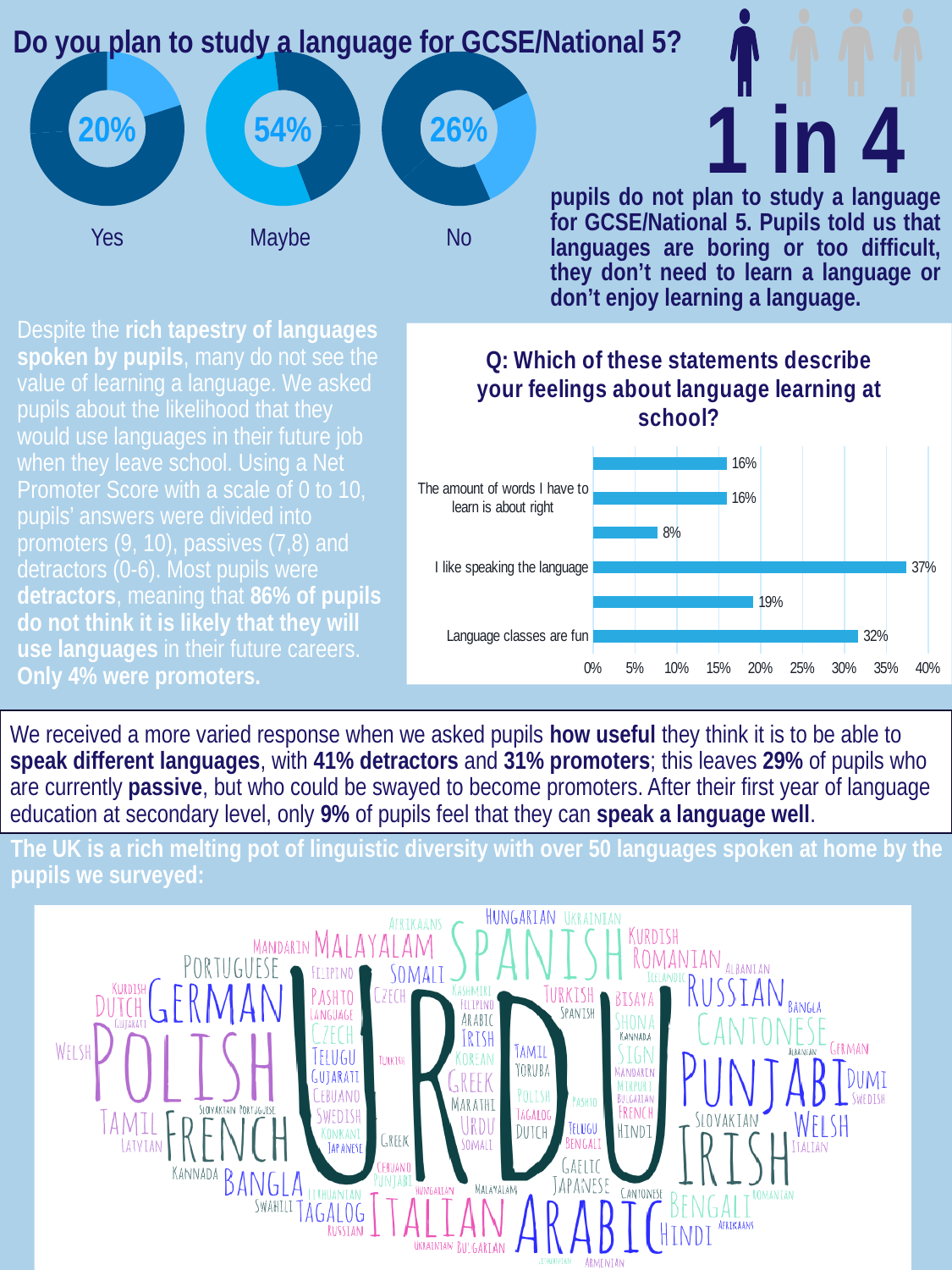
In the bar chart 'Which of these statements describe your feelings about language learning at school?', how many bars are plotted? 6 In the donut charts for 'Do you plan to study a language for GCSE/National 5?', what percentage of pupils answered No? 26% In the donut charts for 'Do you plan to study a language for GCSE/National 5?', what percentage of pupils answered Maybe? 54% In the bar chart 'Which of these statements describe your feelings about language learning at school?', what percentage of pupils said 'The amount of words I have to learn is about right'? 16% In the donut charts for 'Do you plan to study a language for GCSE/National 5?', which response has the highest percentage? Maybe In the donut charts for 'Do you plan to study a language for GCSE/National 5?', which response has the lowest percentage? Yes In the donut charts for 'Do you plan to study a language for GCSE/National 5?', what is the difference in percentage points between Maybe and No? 28% In the donut charts for 'Do you plan to study a language for GCSE/National 5?', what percentage of pupils answered Yes? 20% In the bar chart 'Which of these statements describe your feelings about language learning at school?', what percentage of pupils said 'I like speaking the language'? 37% In the bar chart 'Which of these statements describe your feelings about language learning at school?', which labelled statement has the highest percentage? I like speaking the language What type of chart is used for 'Which of these statements describe your feelings about language learning at school?' Bar chart In the bar chart 'Which of these statements describe your feelings about language learning at school?', what percentage of pupils said 'Language classes are fun'? 32%